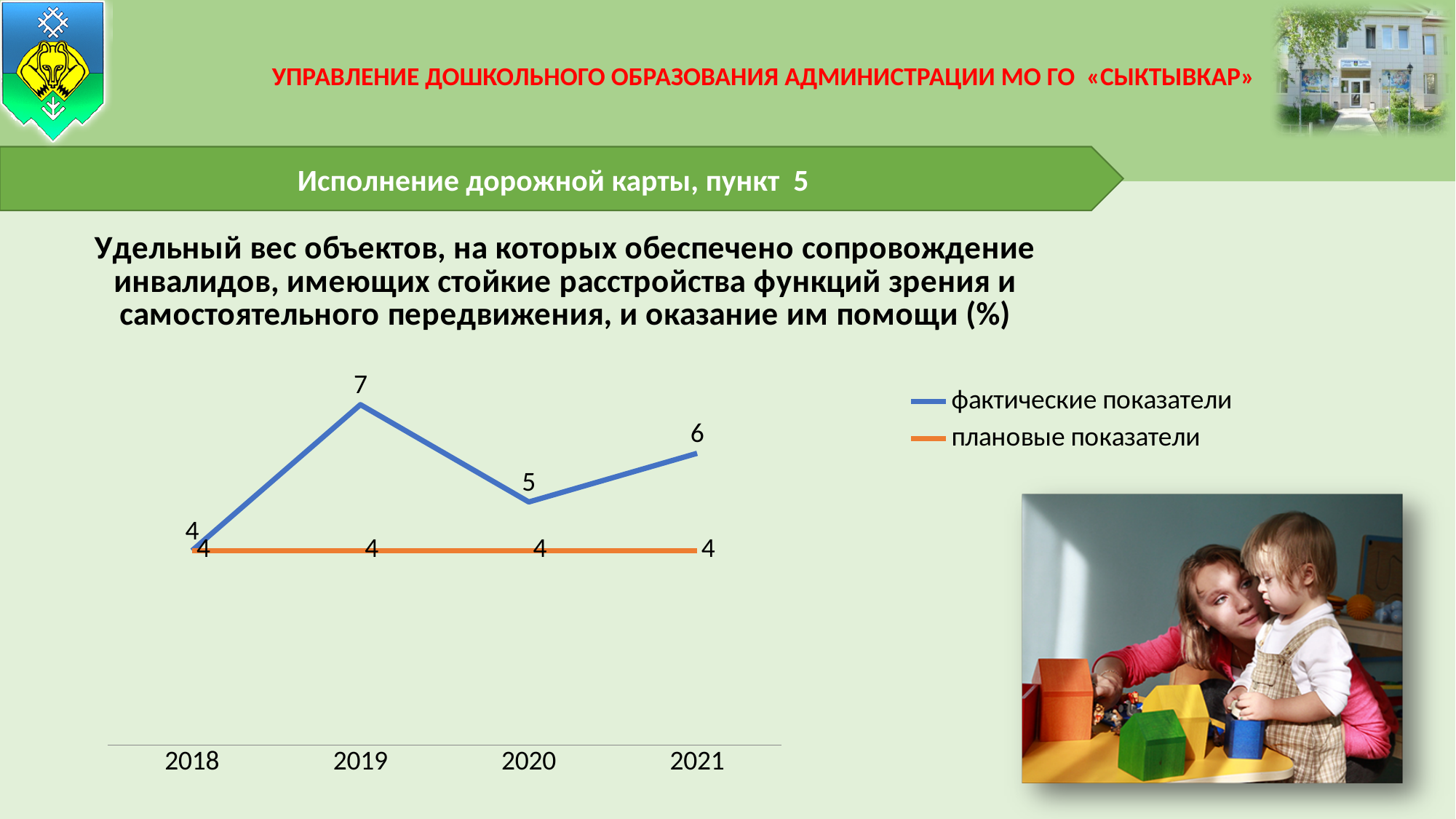
Does the плановые показатели series rise, fall or stay flat from 2018 to 2021? stays flat In which year is the value of фактические показатели lowest? 2018 How many years are shown on the x axis? 4 What is the value of фактические показатели in 2019? 7 What is the value of фактические показатели in 2020? 5 How many series does the legend list? 2 In which year is the value of фактические показатели highest? 2019 What type of chart is shown on the slide? line chart What is the value of плановые показатели in 2021? 4 What is the value of фактические показатели in 2021? 6 Which is larger in 2020: фактические показатели or плановые показатели? фактические показатели What is the difference between фактические показатели and плановые показатели in 2019? 3